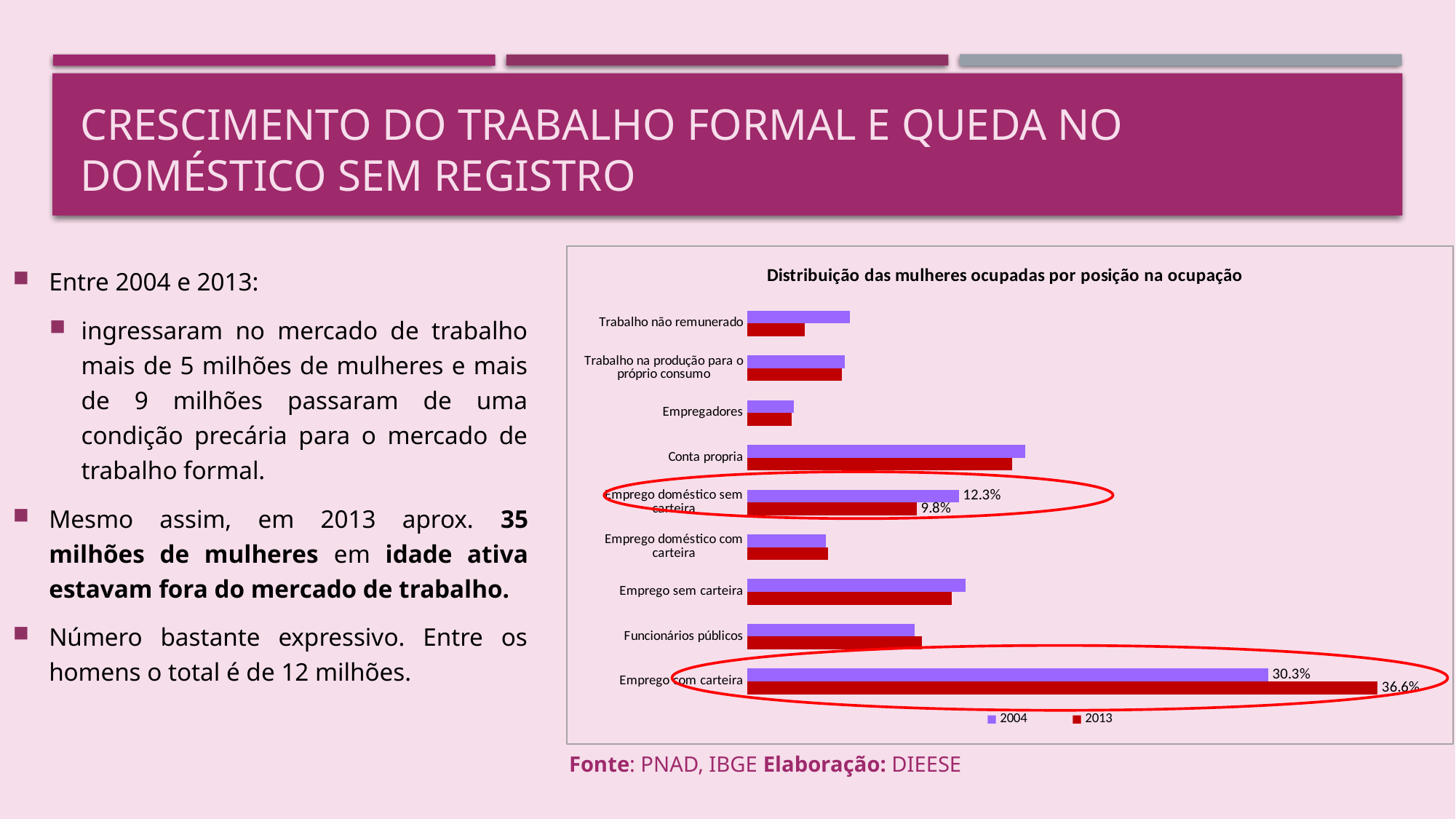
What is the value for Emprego doméstico sem carteira in 2004? 12.3% Which category has the lowest value in 2004? Empregadores What is the value for Emprego com carteira in 2013? 36.6% What is the value for Emprego doméstico sem carteira in 2013? 9.8% How many series does the legend list? 2 For Emprego com carteira, which year has the larger value, 2004 or 2013? 2013 What is the difference between the 2004 and 2013 values for Emprego doméstico sem carteira? 2.5 percentage points By how many percentage points did Emprego com carteira change between 2004 and 2013? 6.3 percentage points Which category has the highest value in 2013? Emprego com carteira What kind of chart is shown on the slide? Bar chart What is the value for Emprego com carteira in 2004? 30.3% How many occupation categories are shown in the chart? 9